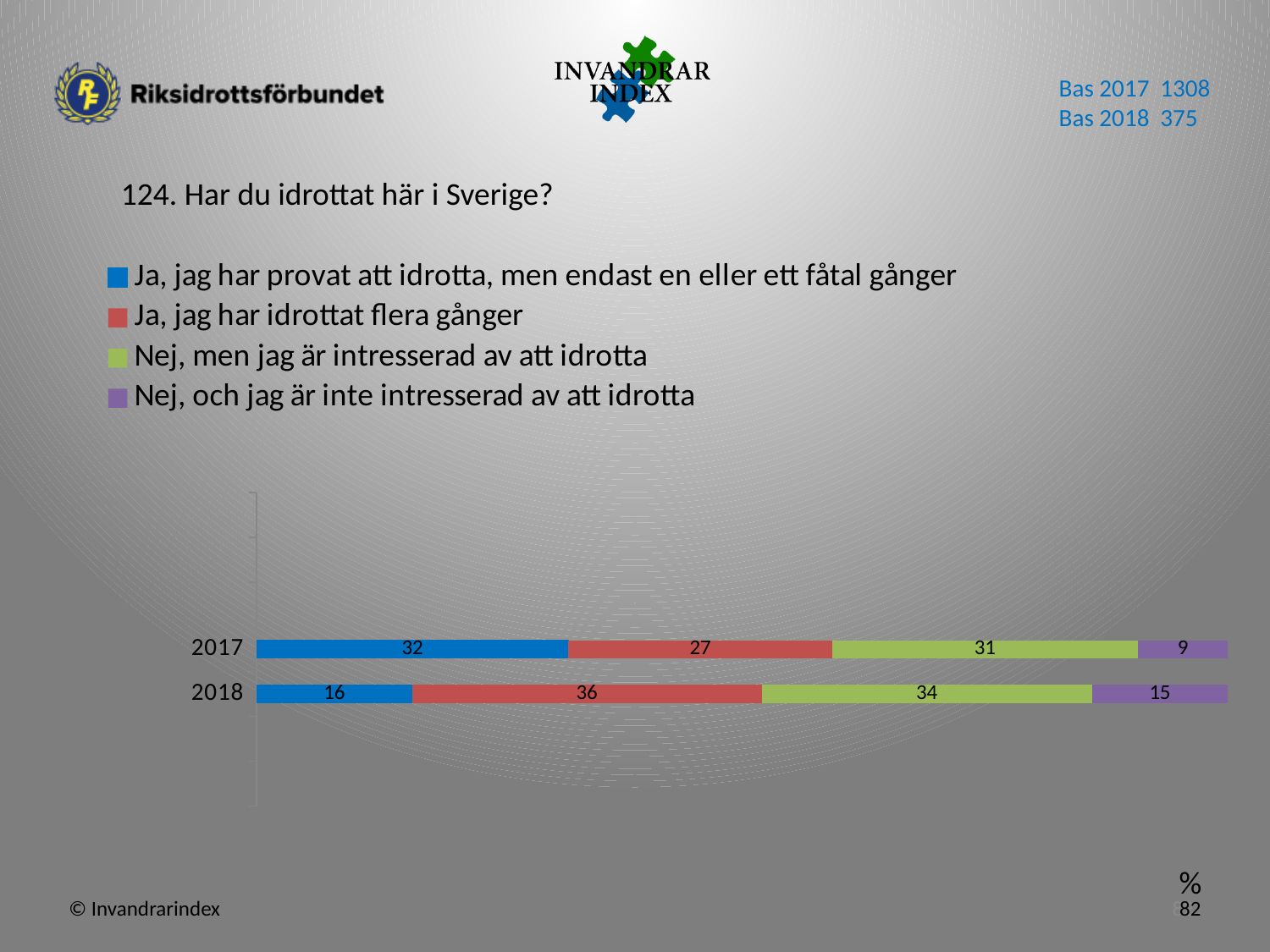
How many series does the legend list? 4 What kind of chart is shown on the slide? Stacked bar chart What is the total of the stacked bar for 2018? 101 How many years (categories) are shown in the chart? 2 What is the value for "Nej, och jag är inte intresserad av att idrotta" in 2017? 9 What is the difference between the 2017 and 2018 values for "Ja, jag har provat att idrotta, men endast en eller ett fåtal gånger"? 16 Which series has the lowest value in 2017? Nej, och jag är inte intresserad av att idrotta What is the value for "Nej, men jag är intresserad av att idrotta" in 2018? 34 What is the value for "Ja, jag har provat att idrotta, men endast en eller ett fåtal gånger" in 2017? 32 Which series has the highest value in 2018? Ja, jag har idrottat flera gånger Which year has the larger value for "Nej, och jag är inte intresserad av att idrotta", 2017 or 2018? 2018 What is the value for "Ja, jag har idrottat flera gånger" in 2018? 36